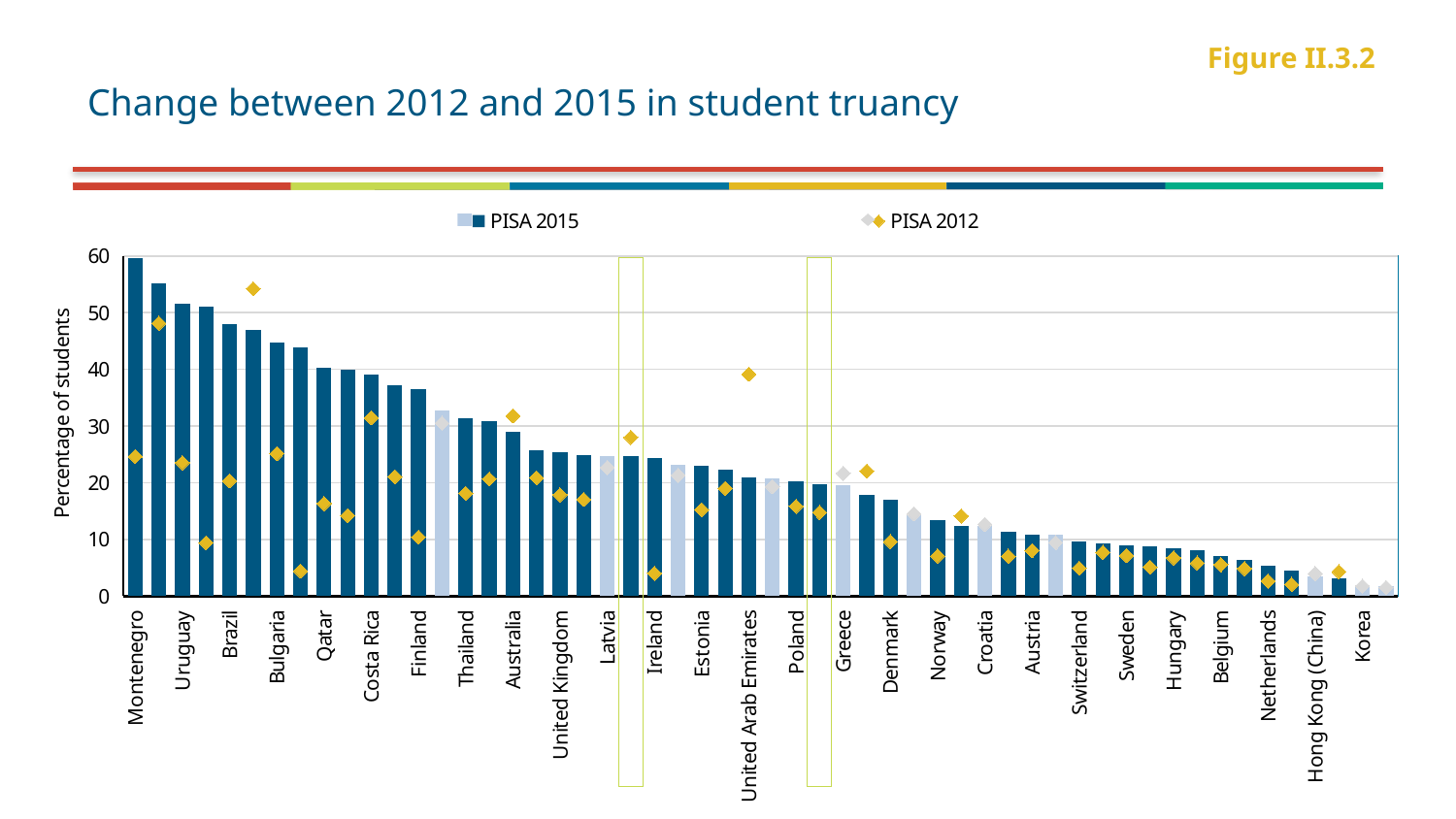
Which country has the highest PISA 2015 value? Montenegro What kind of chart is shown on the slide? bar chart Is the PISA 2012 value for Bulgaria greater or less than 50? less Do the PISA 2015 bars rise or fall from left to right along the x axis? fall Is the PISA 2015 value for Denmark greater or less than 20? less For the United Arab Emirates, which is larger: the PISA 2012 value or the PISA 2015 value? PISA 2012 Which labelled country has the lowest PISA 2015 value? Korea How many series does the legend list? 2 Is the PISA 2015 value for Montenegro greater or less than 50? greater What is the label on the vertical axis? Percentage of students What is the title of the chart? Change between 2012 and 2015 in student truancy